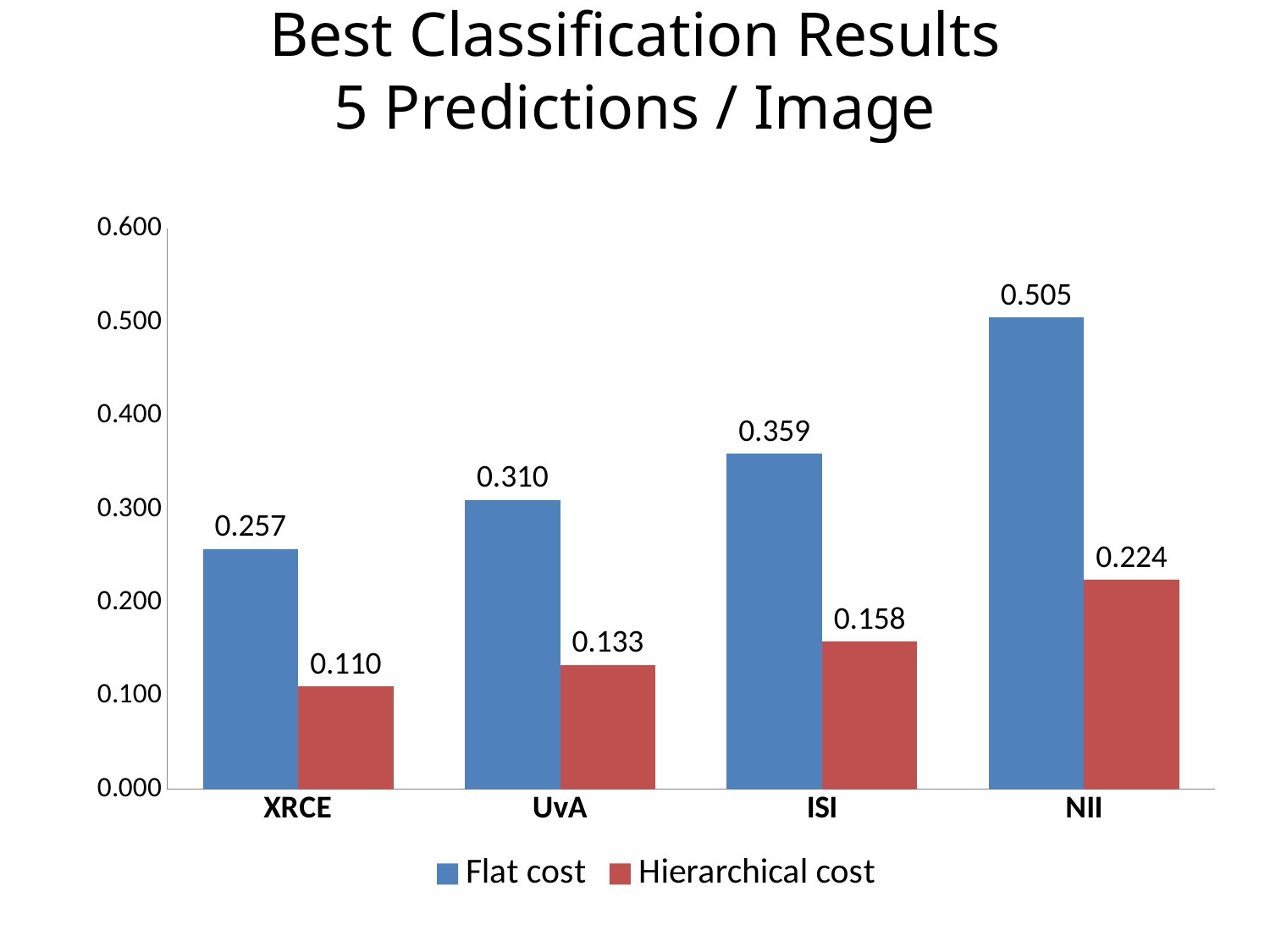
How many categories are shown on the x axis? 4 Which category has the lowest Hierarchical cost? XRCE What is the Hierarchical cost value for UvA? 0.133 Which is larger, the Flat cost for UvA or the Flat cost for ISI? Flat cost for ISI What is the difference between the Flat cost and the Hierarchical cost for ISI? 0.201 What is the Flat cost value for XRCE? 0.257 What is the Hierarchical cost value for NII? 0.224 Do the Flat cost values rise or fall from XRCE to NII along the x axis? Rise Which category has the highest Flat cost? NII Is the Flat cost for NII greater or less than 0.400? greater How many series does the legend list? 2 What kind of chart is shown on the slide? Bar chart